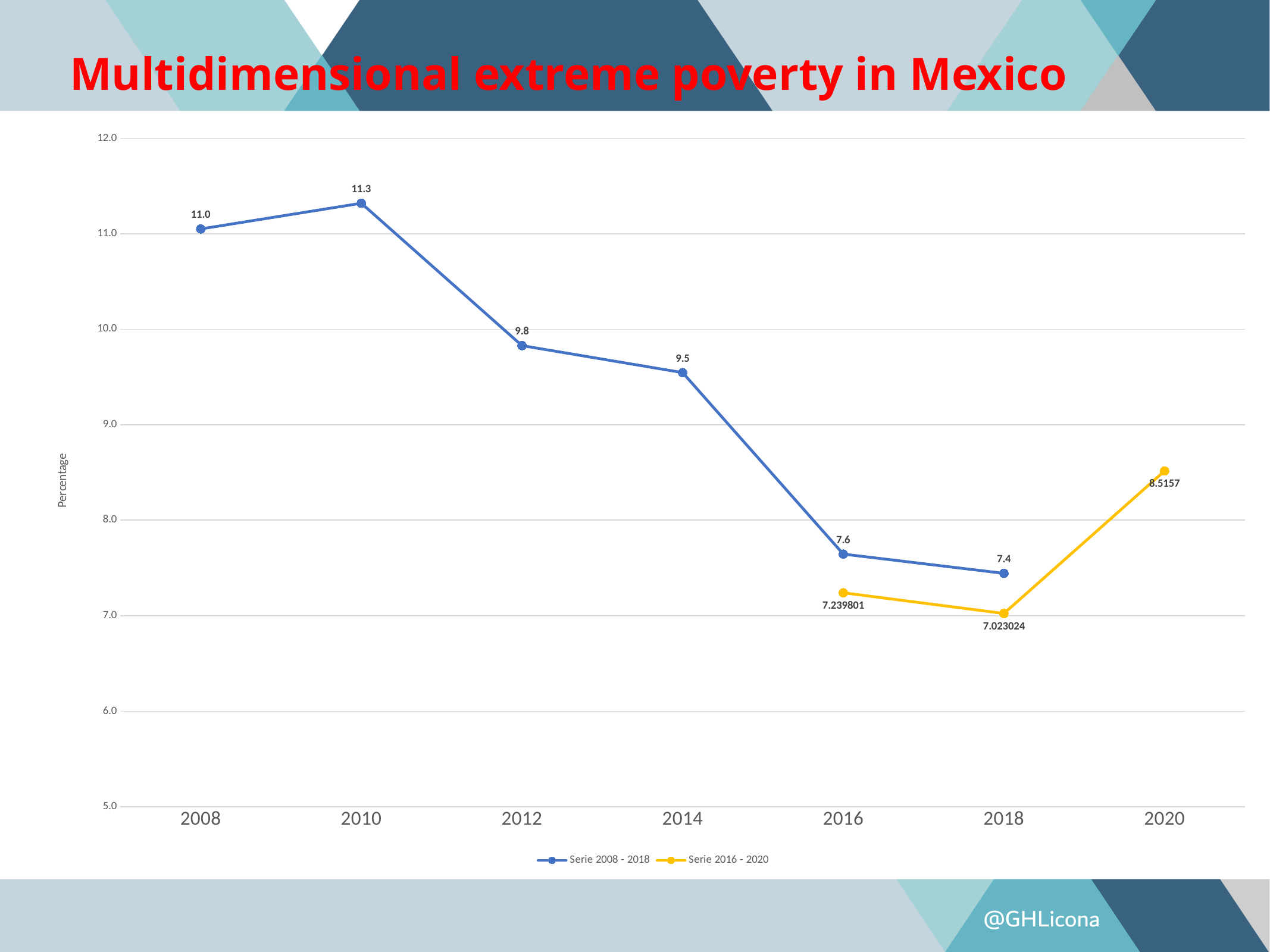
Which is larger in 2016: the Serie 2008 - 2018 value or the Serie 2016 - 2020 value? Serie 2008 - 2018 What is the value for 2010 in the Serie 2008 - 2018 series? 11.3 What kind of chart is shown on the slide? line chart Is the value for 2012 in the Serie 2008 - 2018 series greater or less than 10.0? less How many series does the legend list? 2 Does the Serie 2008 - 2018 series rise or fall from 2010 to 2018? fall Which year has the lowest value in the Serie 2008 - 2018 series? 2018 What is the difference between the 2010 and 2018 values in the Serie 2008 - 2018 series? 3.9 Which year has the highest value in the Serie 2008 - 2018 series? 2010 What is the value for 2020 in the Serie 2016 - 2020 series? 8.5157 What is the value for 2014 in the Serie 2008 - 2018 series? 9.5 What is the value for 2018 in the Serie 2016 - 2020 series? 7.023024